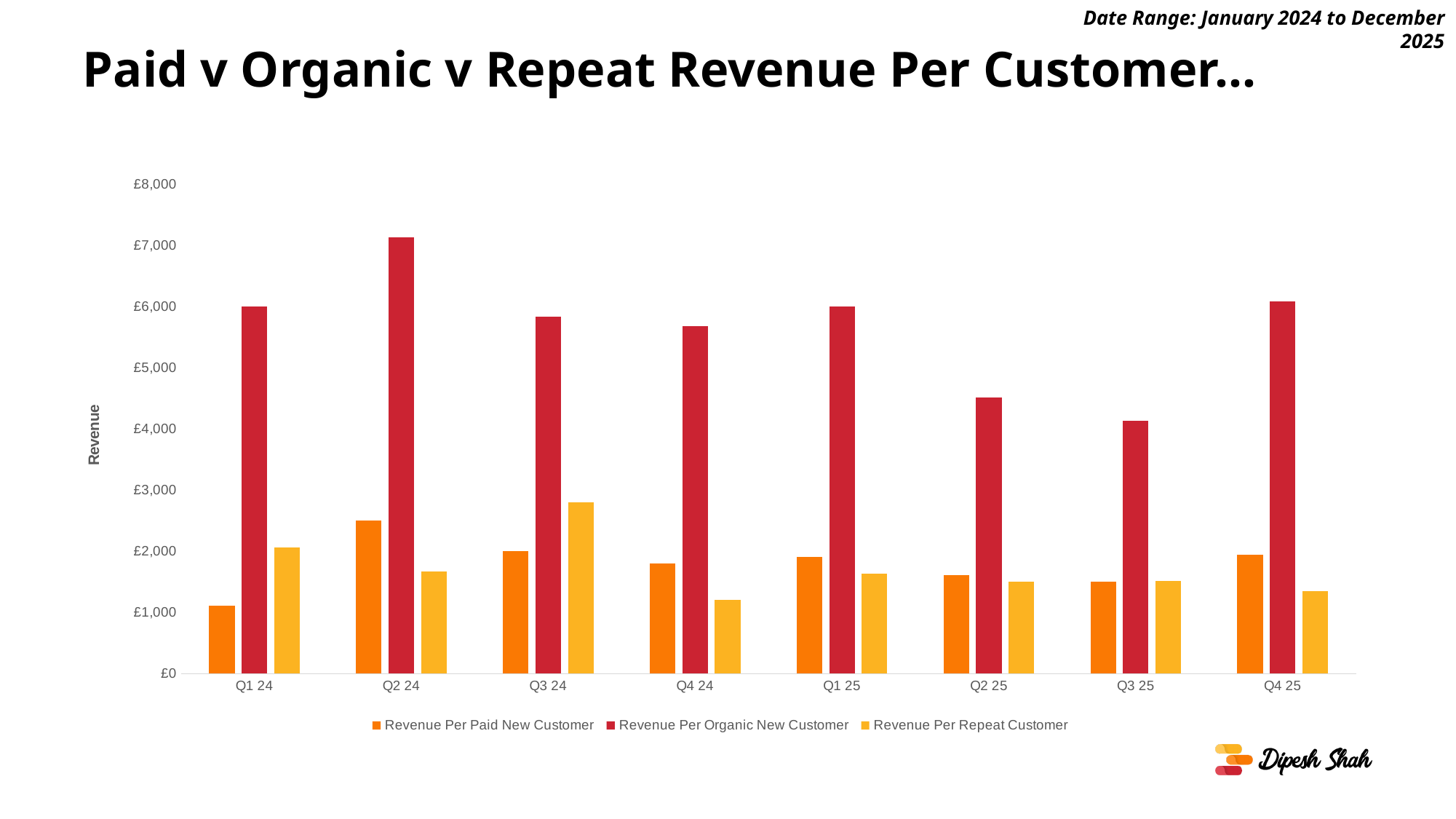
In Q2 24, which is larger: Revenue Per Paid New Customer or Revenue Per Repeat Customer? Revenue Per Paid New Customer In which quarter is Revenue Per Organic New Customer lowest? Q3 25 How many quarters are shown on the x axis? 8 How many series does the legend list? 3 Is the value for Revenue Per Repeat Customer in Q4 24 greater or less than £2,000? less Is the value for Revenue Per Organic New Customer in Q2 24 greater or less than £7,000? greater In which quarter is Revenue Per Paid New Customer lowest? Q1 24 Does Revenue Per Organic New Customer rise or fall from Q1 25 to Q3 25? Fall In which quarter is Revenue Per Repeat Customer highest? Q3 24 What kind of chart is shown on the slide? Bar chart What colour represents Revenue Per Organic New Customer in the legend? Red In which quarter is Revenue Per Organic New Customer highest? Q2 24